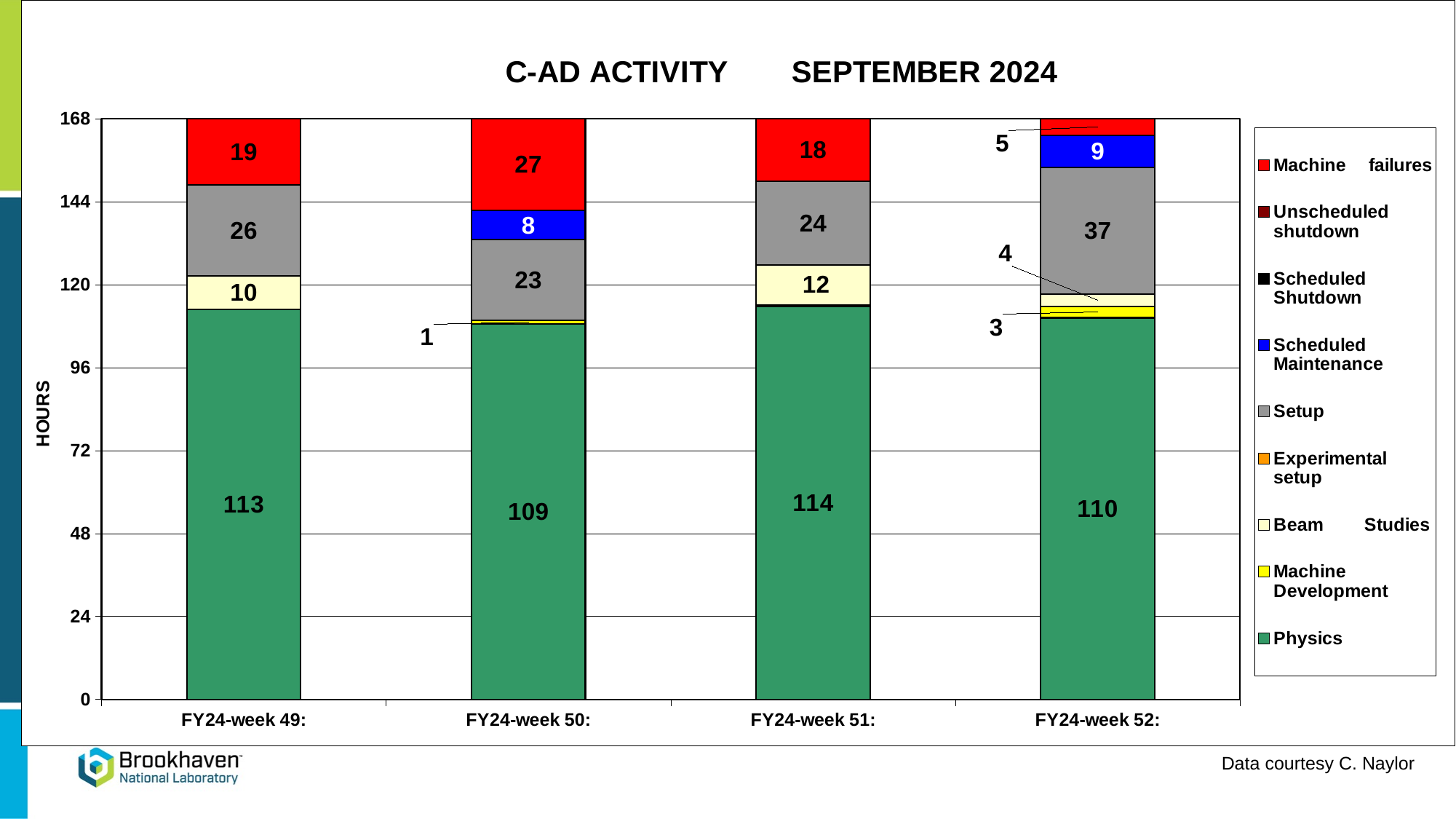
Which week has the highest Physics value? FY24-week 51 What is the difference between the Setup hours in FY24-week 52 and FY24-week 49? 11 How many hours of Physics are shown for FY24-week 49? 113 How many Setup hours are shown for FY24-week 52? 37 How many weeks are shown on the x axis? 4 Which week has the lowest Machine failures value? FY24-week 52 What is the total of the stacked bar for FY24-week 49? 168 What is the Machine failures value for FY24-week 50? 27 How many series does the legend list? 9 What is the Scheduled Maintenance value for FY24-week 52? 9 Which has more Physics hours, FY24-week 50 or FY24-week 52? FY24-week 52 What kind of chart is shown on the slide? Stacked bar chart